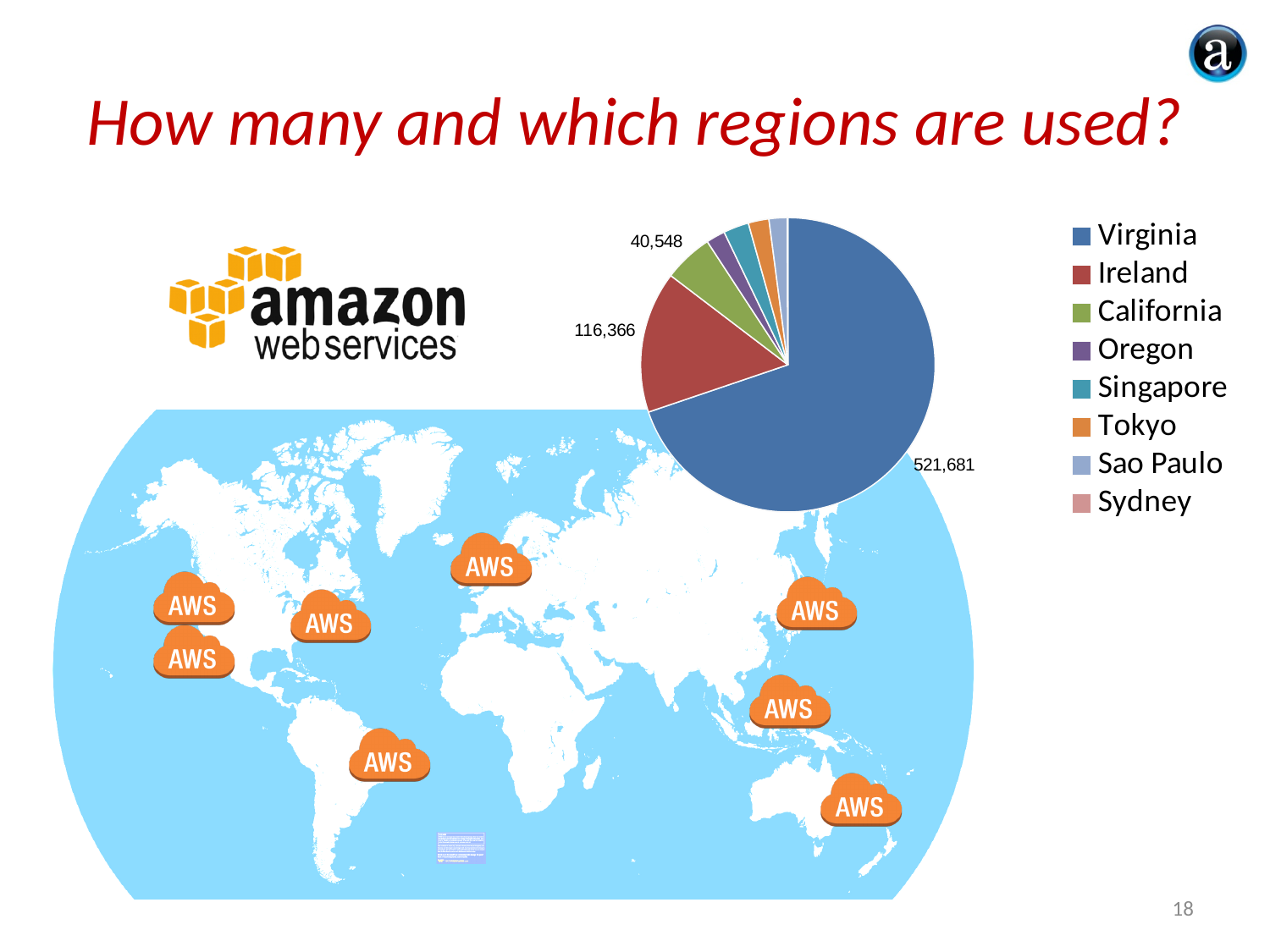
What colour represents Virginia in the pie chart? Blue Which is larger, the value for Virginia or the value for Ireland? Virginia What value is shown for Virginia in the pie chart? 521,681 What is the difference between the values for Virginia and Ireland? 405,315 Which is larger, the value for Ireland or the value for California? Ireland How many regions are listed in the pie chart's legend? 8 What value is shown for Ireland in the pie chart? 116,366 What value is shown for California in the pie chart? 40,548 What kind of chart is shown on the slide? Pie chart Which region has the largest slice in the pie chart? Virginia What is the difference between the values for Ireland and California? 75,818 Which region is listed last in the pie chart's legend? Sydney